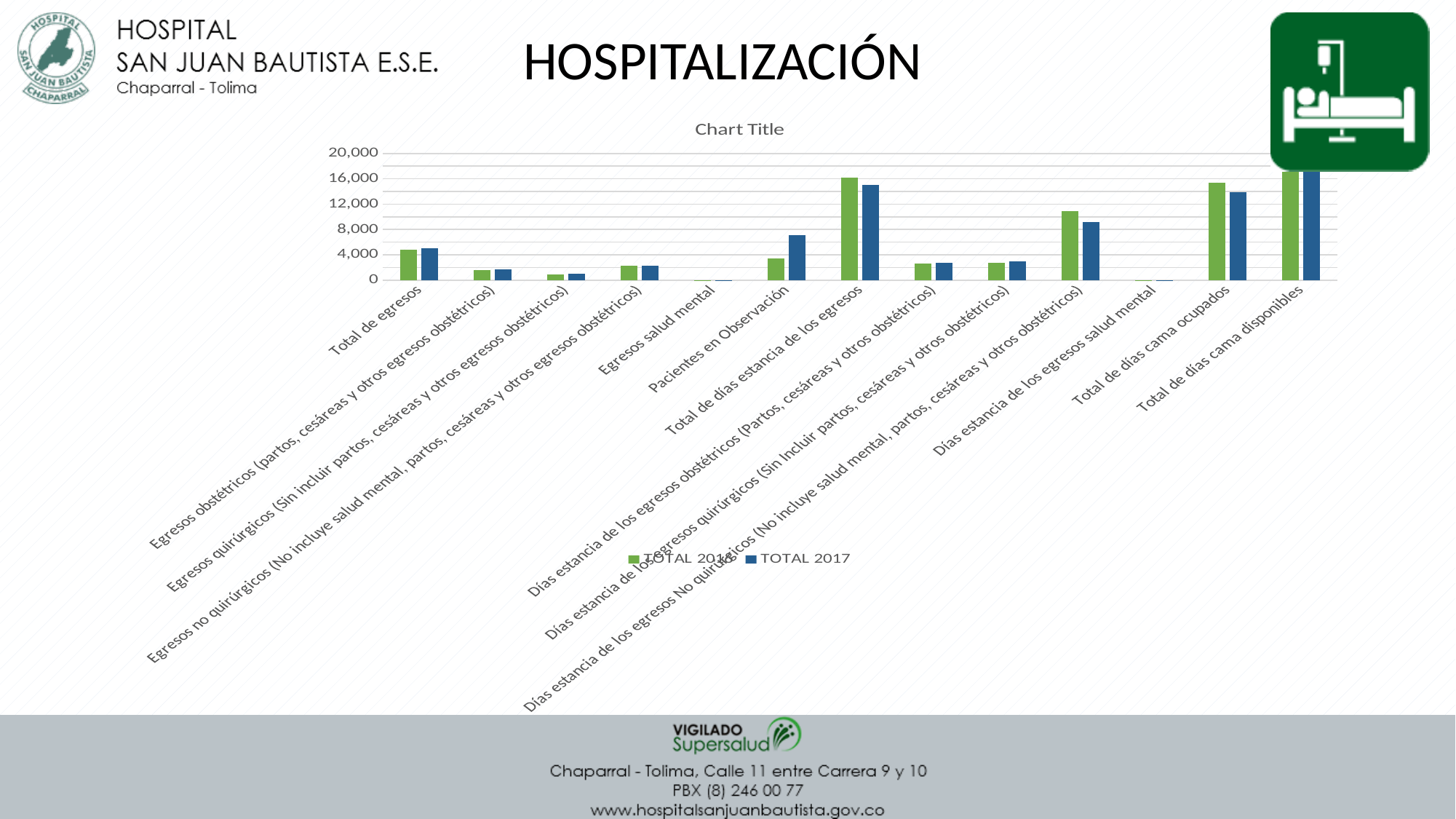
Is the TOTAL 2016 value for Total de días estancia de los egresos greater or less than 12,000? greater What kind of chart is shown on the slide? bar chart For Pacientes en Observación, which series has the larger value, TOTAL 2016 or TOTAL 2017? TOTAL 2017 What title is printed above the chart? Chart Title Is the TOTAL 2016 value for Total de egresos greater or less than 4,000? greater Which category has the highest TOTAL 2017 value? Total de días cama disponibles How many series does the legend list? 2 Is the TOTAL 2016 value for Egresos obstétricos (partos, cesáreas y otros egresos obstétricos) greater or less than 4,000? less For Total de días cama ocupados, which series has the larger value, TOTAL 2016 or TOTAL 2017? TOTAL 2016 What are the two series named in the legend? TOTAL 2016 and TOTAL 2017 How many categories are plotted along the x axis? 13